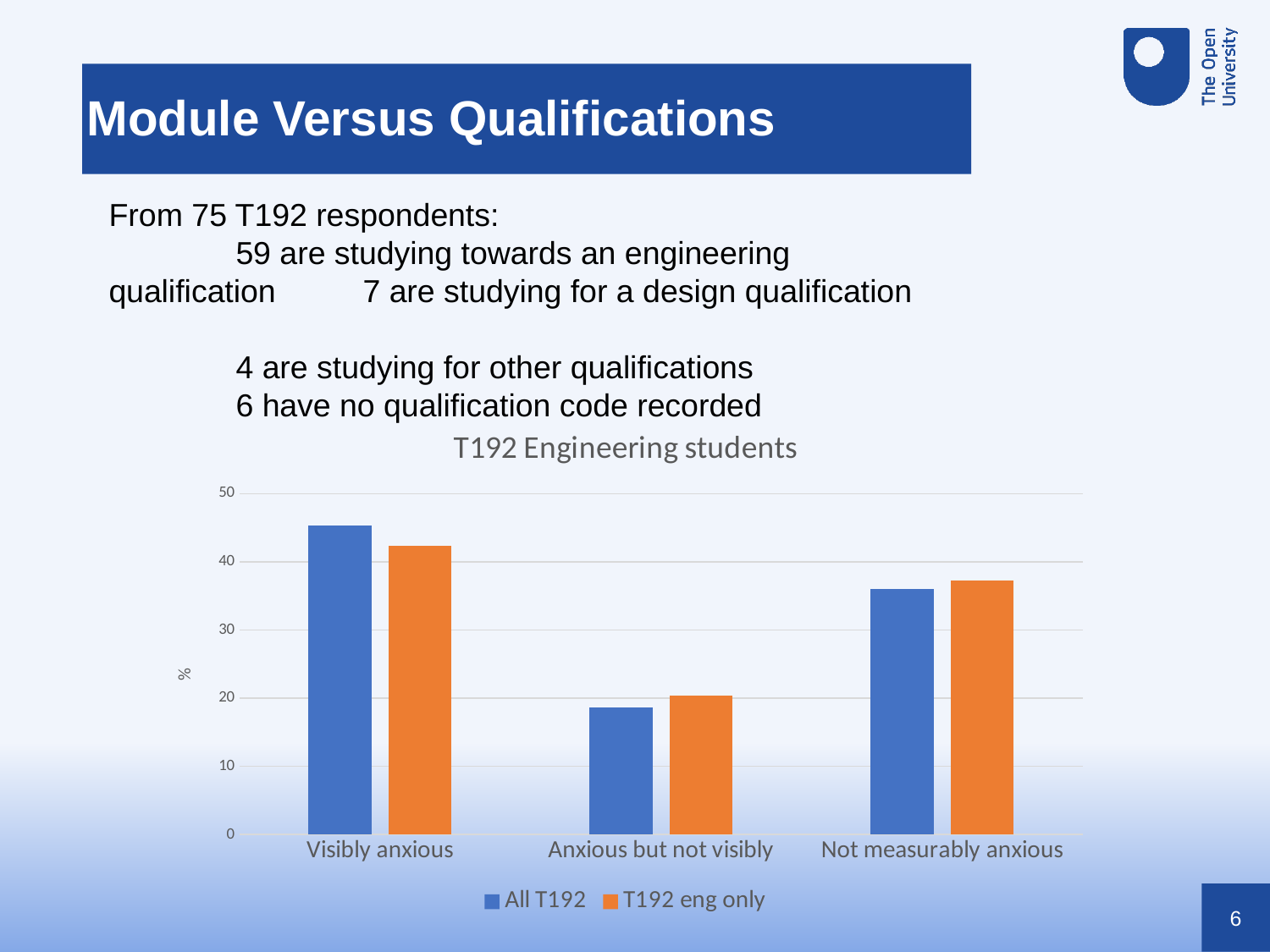
Which series is shown in orange in the chart? T192 eng only Is the T192 eng only value for Not measurably anxious greater or less than 40? less Is the All T192 value for Visibly anxious greater or less than 40? greater What is the title of the chart? T192 Engineering students Which category has the highest value for the All T192 series? Visibly anxious For Anxious but not visibly, which series has the larger value, All T192 or T192 eng only? T192 eng only Which category has the lowest value for the T192 eng only series? Anxious but not visibly How many categories are shown on the x axis of the chart? 3 For Visibly anxious, which series has the larger value, All T192 or T192 eng only? All T192 How many series does the chart's legend list? 2 What kind of chart is shown on the slide? bar chart